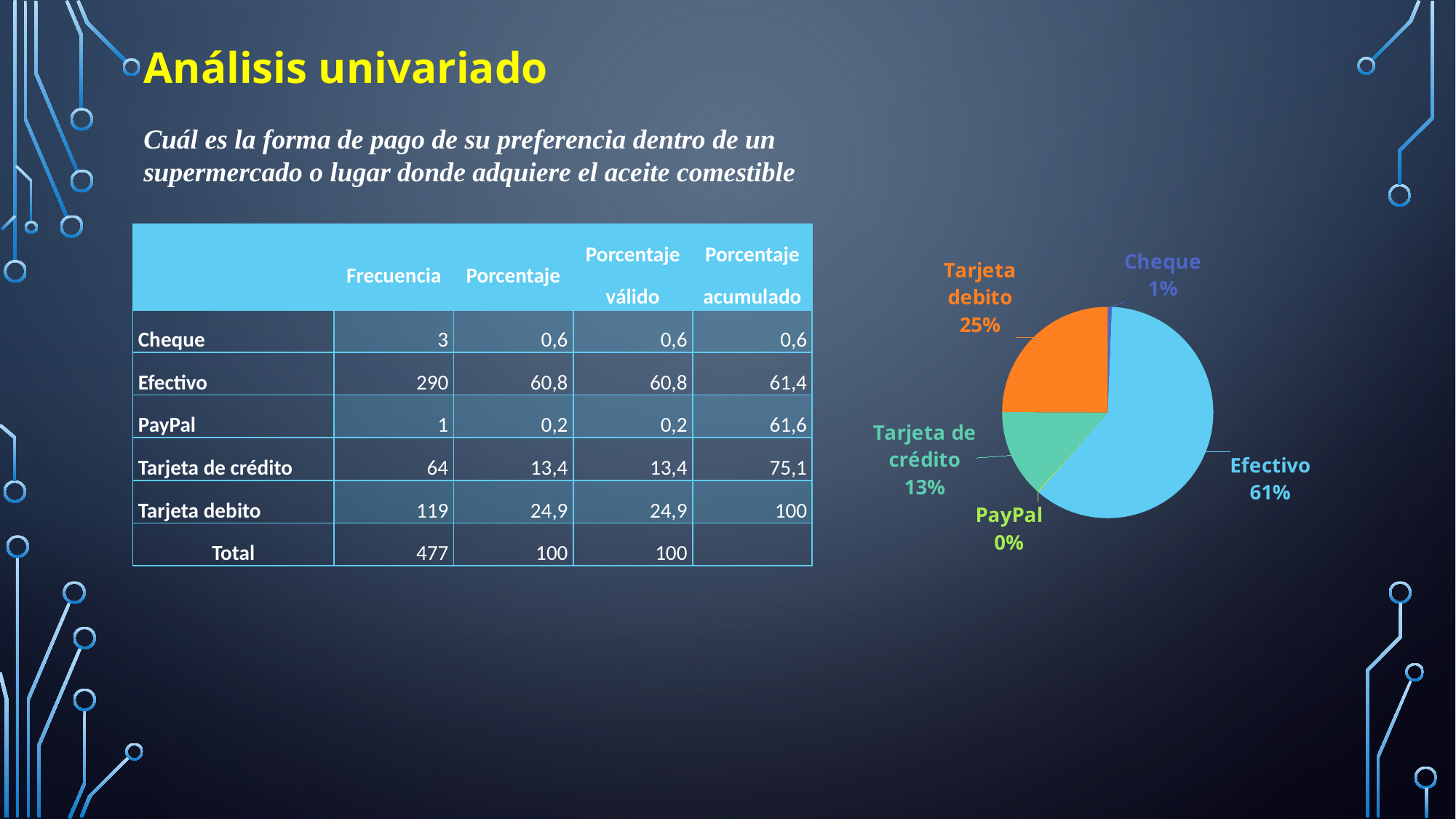
In the pie chart, which is larger: Tarjeta debito or Tarjeta de crédito? Tarjeta debito What kind of chart is shown on the slide? pie chart What colour is the Efectivo slice in the pie chart? light blue What is the difference in percentage points between Efectivo and Tarjeta debito in the pie chart? 36 What percentage does the pie chart show for Cheque? 1% What percentage does the pie chart show for PayPal? 0% Which payment method has the smallest slice in the pie chart? PayPal What percentage does the pie chart show for Tarjeta de crédito? 13% What percentage does the pie chart show for Tarjeta debito? 25% What percentage does the pie chart show for Efectivo? 61% Which payment method has the largest slice in the pie chart? Efectivo How many slices (categories) are labelled in the pie chart? 5